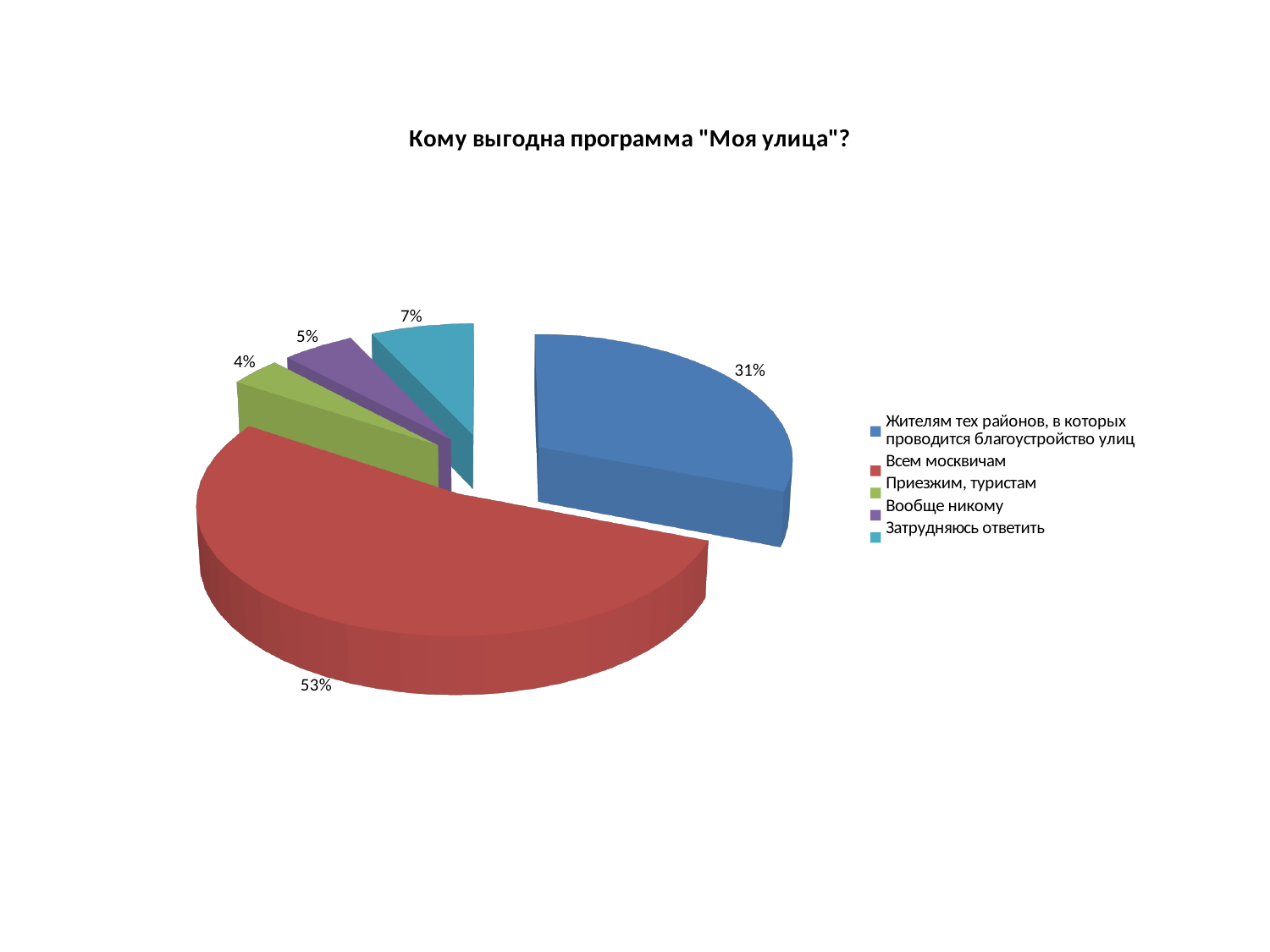
What type of chart is shown on the slide? pie chart What percentage is shown for "Жителям тех районов, в которых проводится благоустройство улиц"? 31% What is the title of the chart? Кому выгодна программа "Моя улица"? Which category has the smallest share of the pie? Приезжим, туристам Which category has the largest share of the pie? Всем москвичам What percentage is shown for "Приезжим, туристам"? 4% What percentage of the pie is labelled for "Всем москвичам"? 53% What percentage is shown for "Затрудняюсь ответить"? 7% What is the difference in percentage points between "Всем москвичам" and "Жителям тех районов, в которых проводится благоустройство улиц"? 22 How many categories does the legend list? 5 What percentage is shown for "Вообще никому"? 5% Which is larger: the share for "Затрудняюсь ответить" or the share for "Вообще никому"? Затрудняюсь ответить